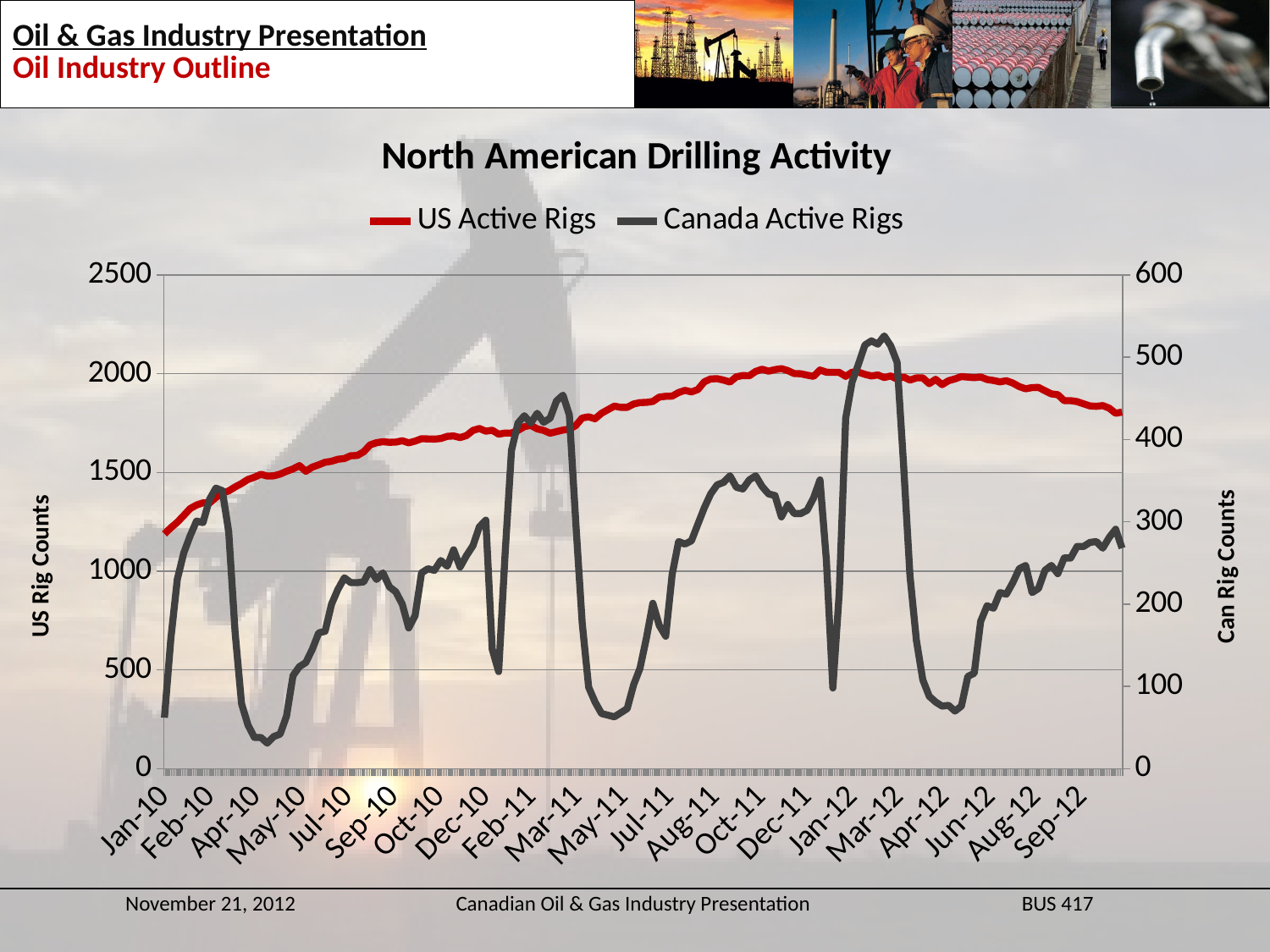
Is the peak value for Canada Active Rigs in early 2012 greater or less than 500 on the right axis? greater What is the highest tick value shown on the left (US Rig Counts) axis? 2500 Is the value for US Active Rigs in Jan-10 greater or less than 1000? greater Do the US Active Rigs values rise or fall from Jan-10 to Dec-11? rise Is the value for US Active Rigs in Sep-12 greater or less than 1500? greater Which is larger for US Active Rigs: the value in Jan-10 or the value in Sep-12? Sep-12 What type of chart is shown on the slide? Line chart What is the title of the chart? North American Drilling Activity Which series is drawn in red? US Active Rigs How many series does the legend list? 2